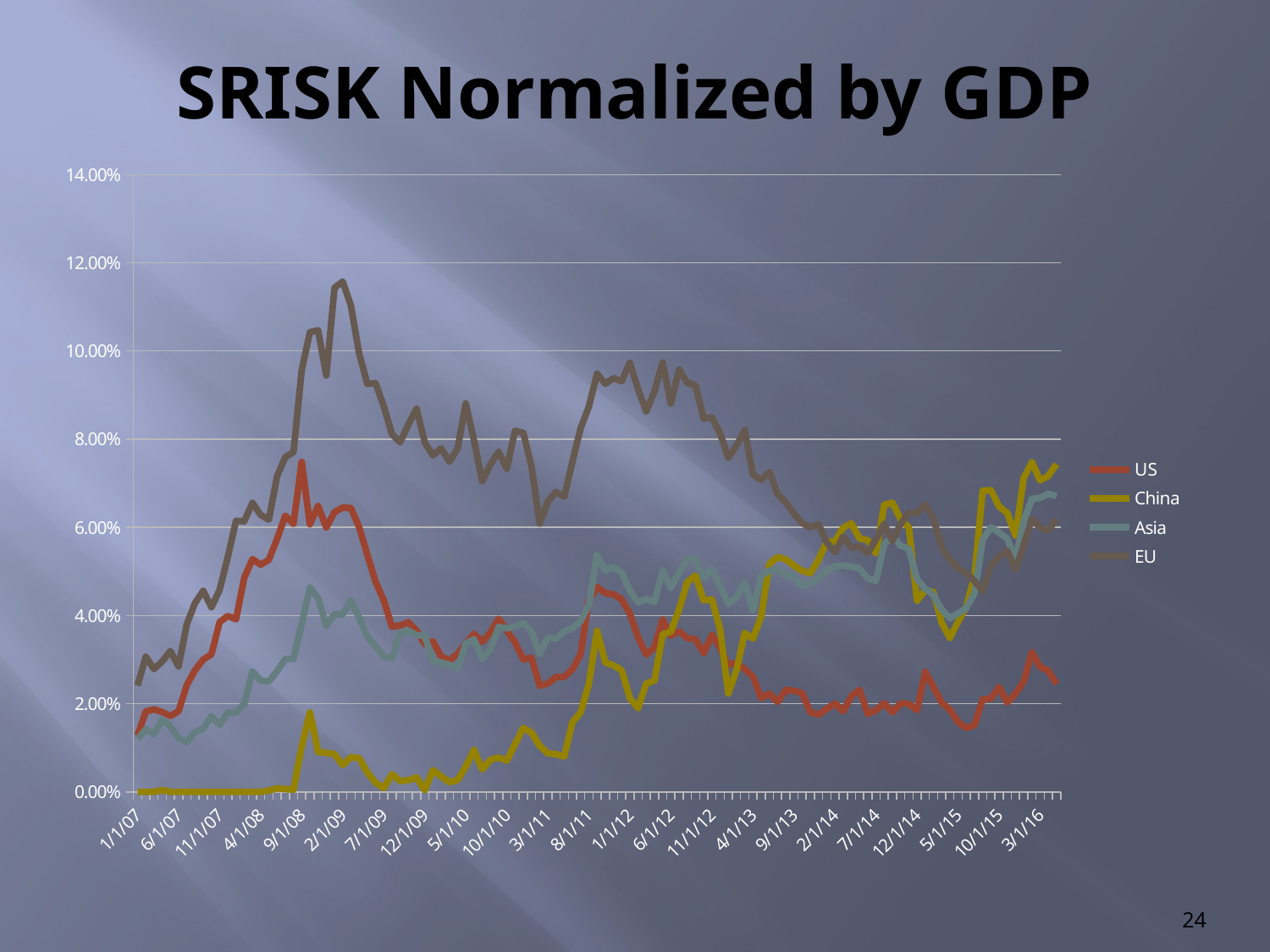
Which series are listed in the legend? US, China, Asia, EU Is the peak value of the EU series around 2/1/09 greater or less than 10.00%? greater At 3/1/16, which is larger, the value for China or the value for US? China Is the value for China at 1/1/07 greater or less than 2.00%? less How many series does the legend list? 4 Is the value for China at 3/1/16 greater or less than 6.00%? greater What kind of chart is shown on the slide? Line chart Which series reaches the highest value anywhere on the chart? EU Does the China series generally rise or fall from 1/1/07 to 3/1/16? rise Which series has the lowest value at 1/1/07? China What is the title of the chart? SRISK Normalized by GDP